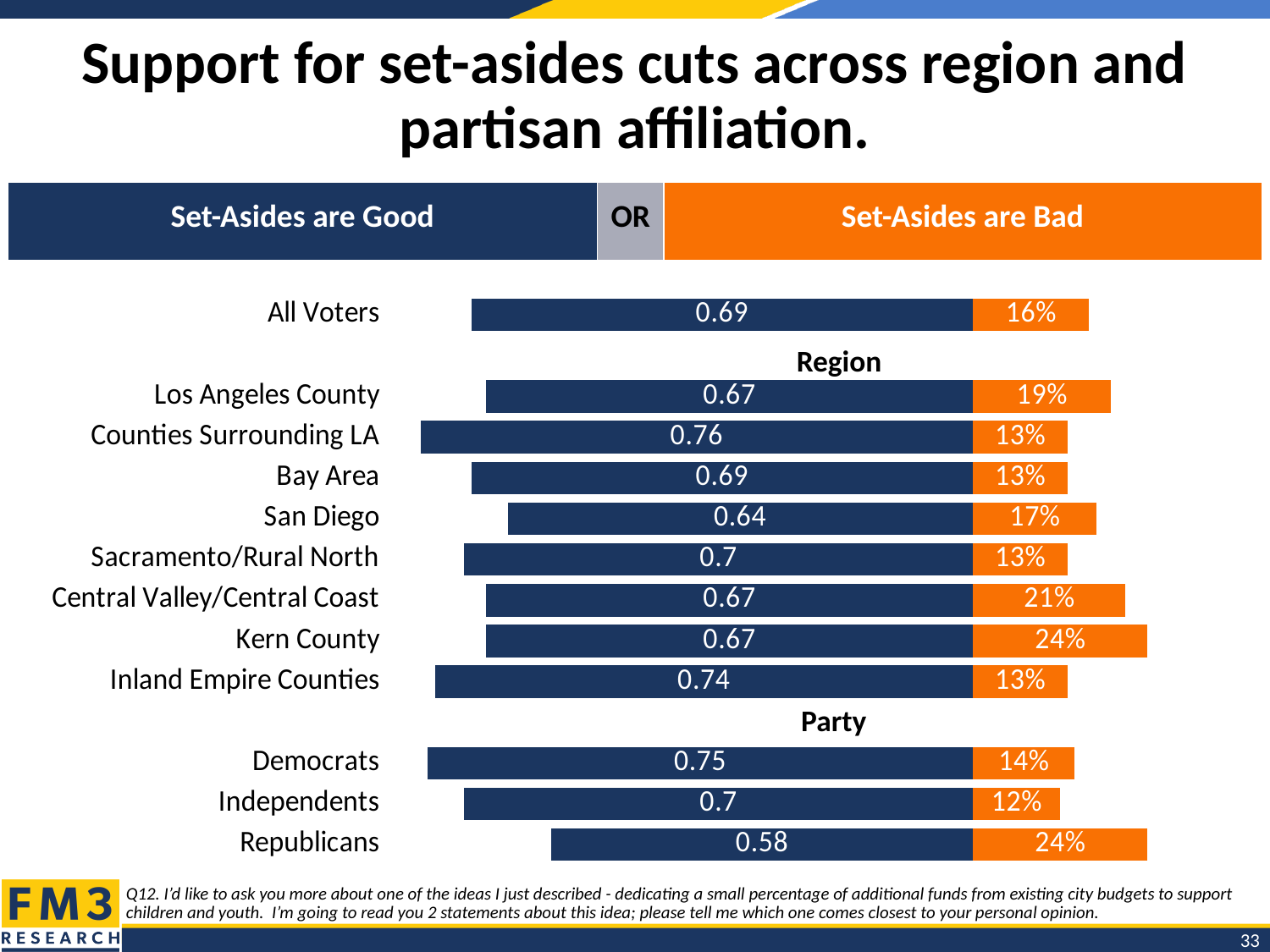
What is the difference between the 'Set-Asides are Good' values for Counties Surrounding LA and Republicans? 0.18 Which category has the lowest 'Set-Asides are Bad' value? Independents What is the 'Set-Asides are Good' value shown for Republicans? 0.58 How many categories (rows) are plotted in the chart? 12 Which category has the highest 'Set-Asides are Good' value? Counties Surrounding LA What is the 'Set-Asides are Good' value shown for All Voters? 0.69 Which has a larger 'Set-Asides are Good' value, Democrats or San Diego? Democrats What is the difference between the 'Set-Asides are Bad' values for Kern County and Bay Area? 11 percentage points What is the 'Set-Asides are Bad' value shown for Kern County? 24% What type of chart is shown on the slide? Bar chart What is the 'Set-Asides are Bad' value shown for Independents? 12% Which category has the lowest 'Set-Asides are Good' value? Republicans